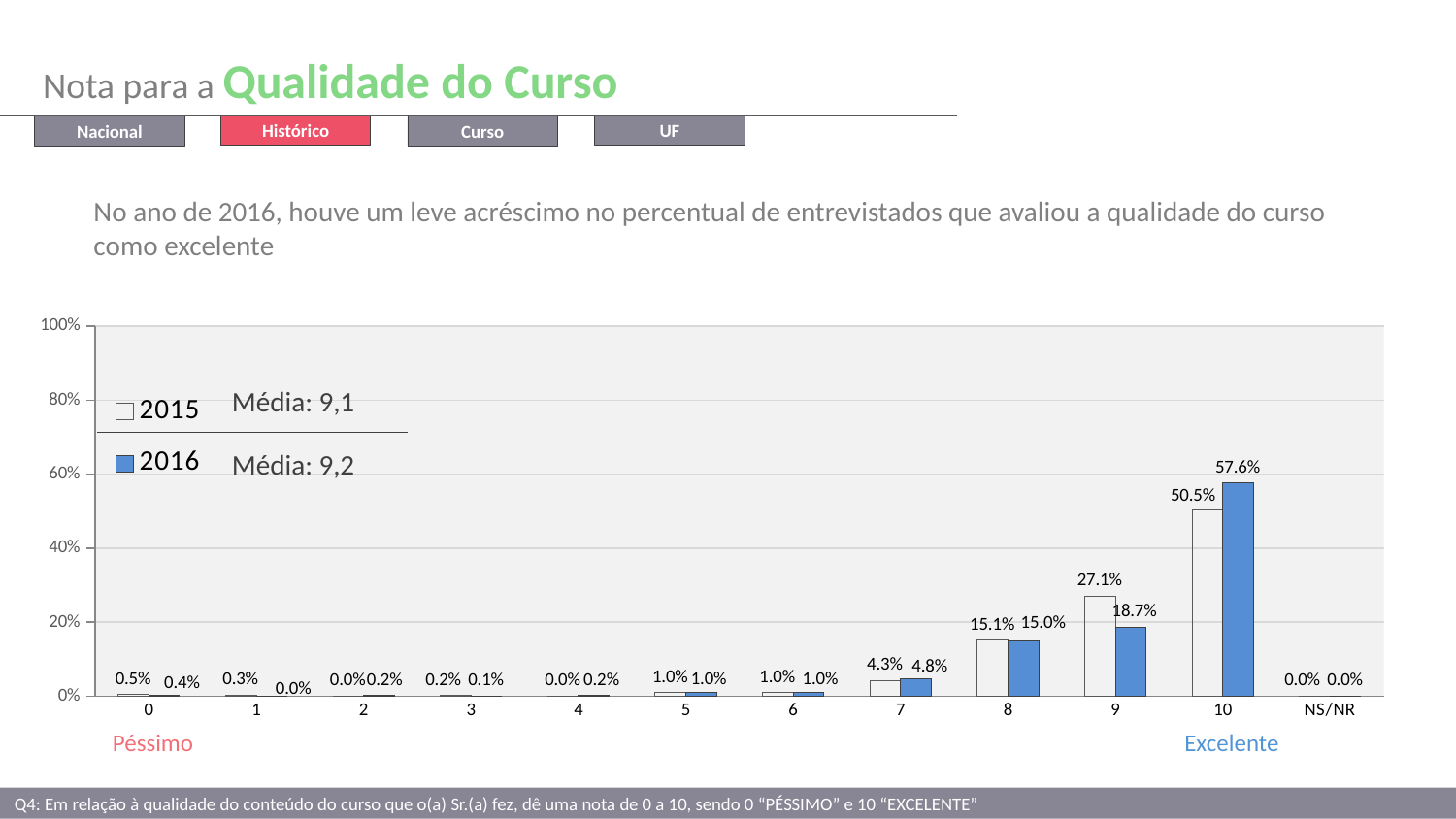
For category 9, which series has the larger value, 2015 or 2016? 2015 What is the average (Média) shown for 2016? 9,2 Which category has the highest value in the 2015 series? 10 What is the difference between the 2015 and 2016 values for category 9? 8.4% How many series does the legend list? 2 How many categories are shown on the x axis? 12 What kind of chart is shown on the slide? bar chart What is the value for category 10 in the 2016 series? 57.6% What is the value for category 9 in the 2015 series? 27.1% Is the value for category 10 in the 2016 series greater or less than 40%? greater What is the difference between the 2016 and 2015 values for category 10? 7.1% What is the value for category 7 in the 2016 series? 4.8%